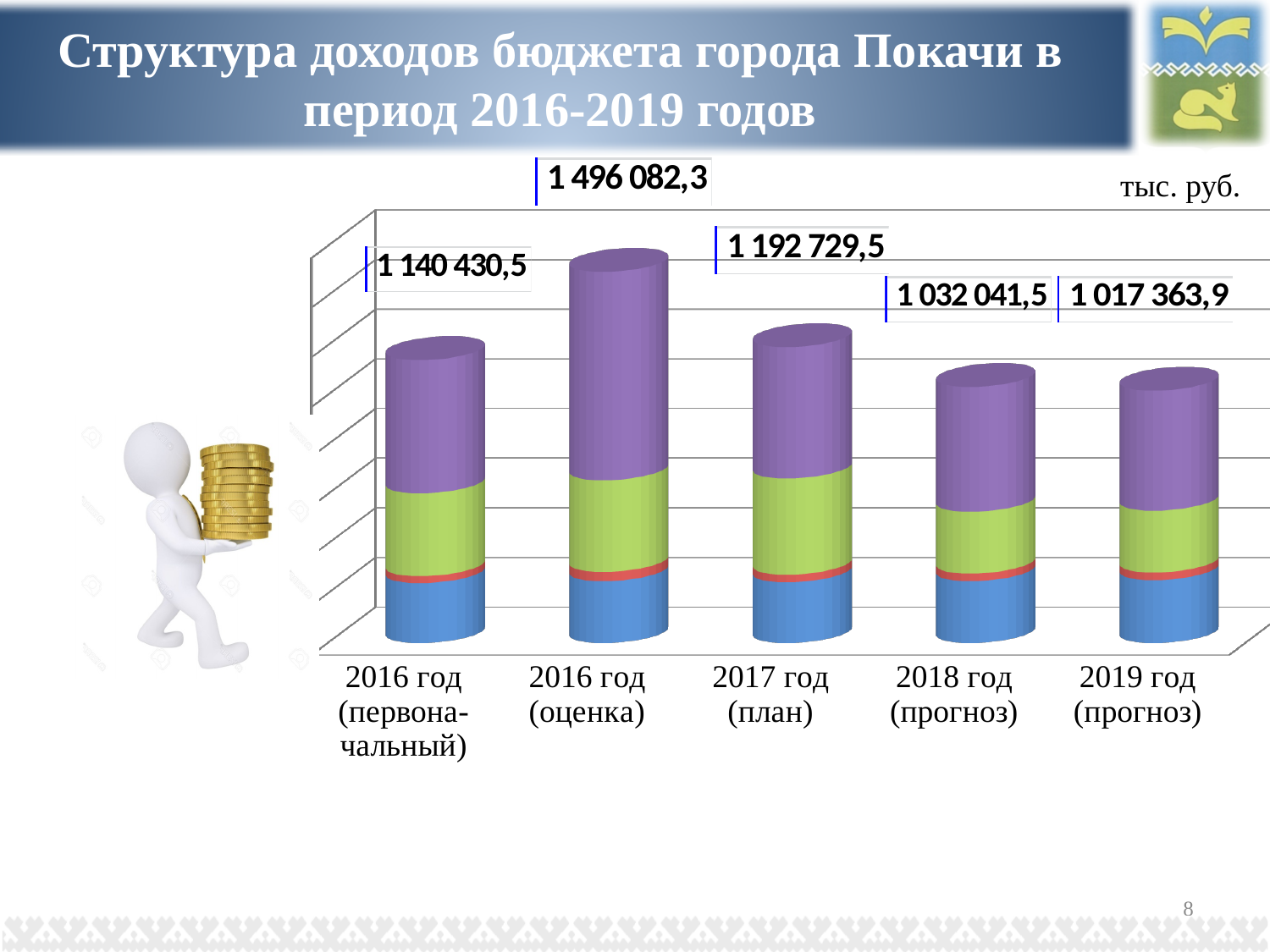
Which category has the highest total value? 2016 год (оценка) What is the difference between the totals for 2016 год (оценка) and 2016 год (первоначальный)? 355 651,8 Which has a larger total, 2018 год (прогноз) or 2019 год (прогноз)? 2018 год (прогноз) What kind of chart is shown on the slide? Stacked bar chart From 2016 год (оценка) to 2019 год (прогноз), do the total values rise or fall? Fall What is the difference between the totals for 2017 год (план) and 2018 год (прогноз)? 160 688,0 What is the total value shown for 2016 год (первоначальный)? 1 140 430,5 What is the total value shown for 2016 год (оценка)? 1 496 082,3 What is the total value shown for 2017 год (план)? 1 192 729,5 Which category has the lowest total value? 2019 год (прогноз) What is the total value shown for 2019 год (прогноз)? 1 017 363,9 How many categories are shown on the x axis? 5